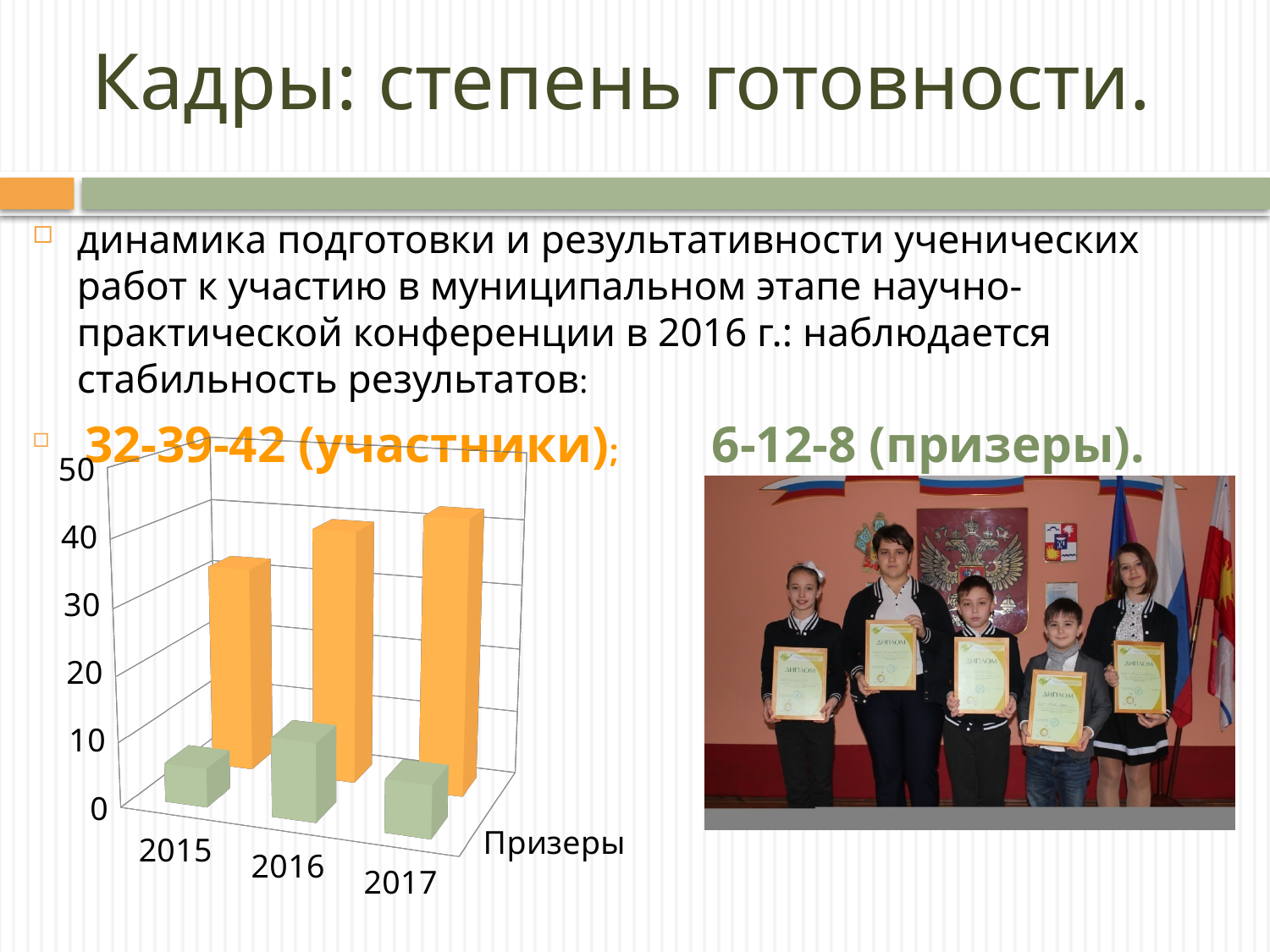
Is the green (Призеры) bar for 2015 greater or less than 10? less What colour are the bars of the series labelled Призеры? green Do the orange bars rise or fall from 2015 to 2017? rise Is the orange bar for 2015 greater or less than 20? greater Which is larger, the green (Призеры) bar for 2016 or the green bar for 2015? 2016 Which year has the highest green (Призеры) bar in the chart? 2016 Is the green (Призеры) bar for 2017 greater or less than 20? less What kind of chart is shown on the slide? bar chart How many years are shown along the x axis of the chart? 3 Which is larger, the orange bar for 2016 or the orange bar for 2015? 2016 Which year has the lowest orange bar in the chart? 2015